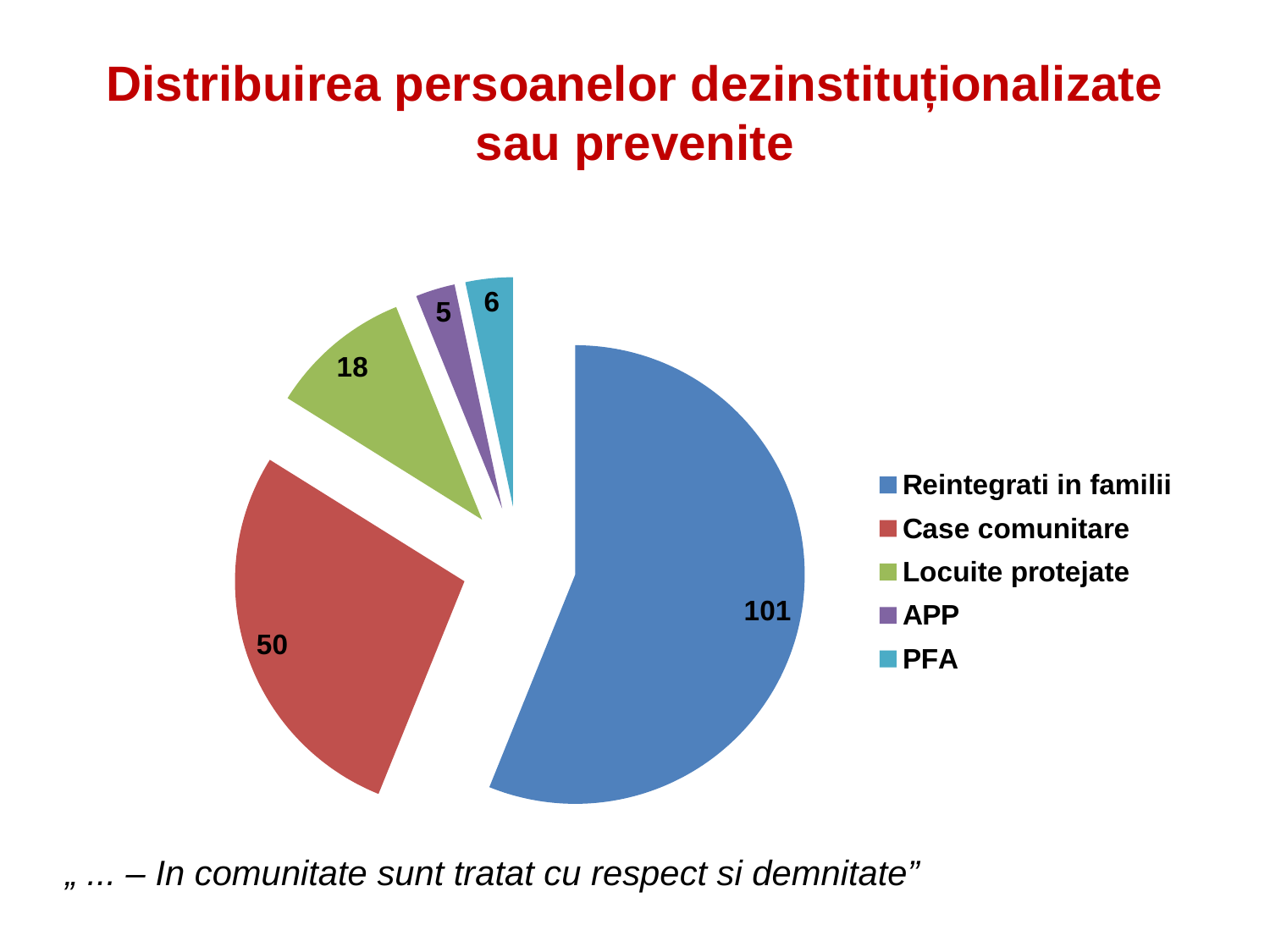
What is the value for Case comunitare? 50 What is the difference between the values for Reintegrati in familii and Case comunitare? 51 What share of the pie does Locuite protejate represent? 10% Which is larger, the value for PFA or the value for APP? PFA How many entries does the legend list? 5 How many slices does the pie chart have? 5 Which category has the largest slice? Reintegrati in familii What is the value for Reintegrati in familii? 101 What kind of chart is shown on the slide? Pie chart What is the value for Locuite protejate? 18 Which category has the smallest slice? APP What is the value for PFA? 6